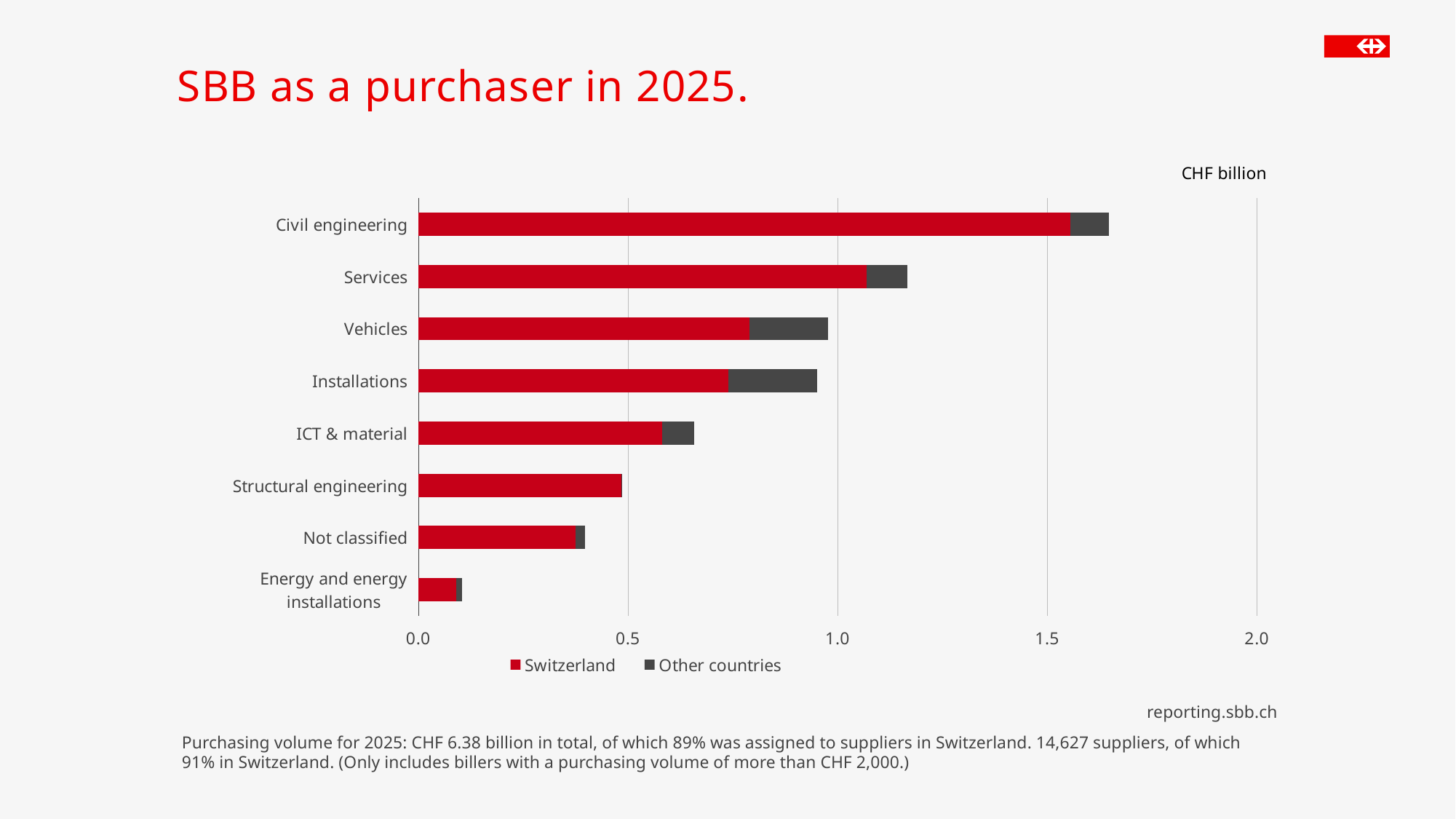
What unit is the x axis measured in? CHF billion Which series is shown in red in the legend? Switzerland Which has a larger total purchasing volume, Services or Vehicles? Services Is the total value for Services greater or less than 1.0? greater Is the total value for Civil engineering greater or less than 1.5? greater How many categories are shown on the chart? 8 Is the total value for Not classified greater or less than 0.5? less What kind of chart is shown on the slide? bar chart Which category has the highest total purchasing volume? Civil engineering Which category has the lowest total purchasing volume? Energy and energy installations How many series does the legend list? 2